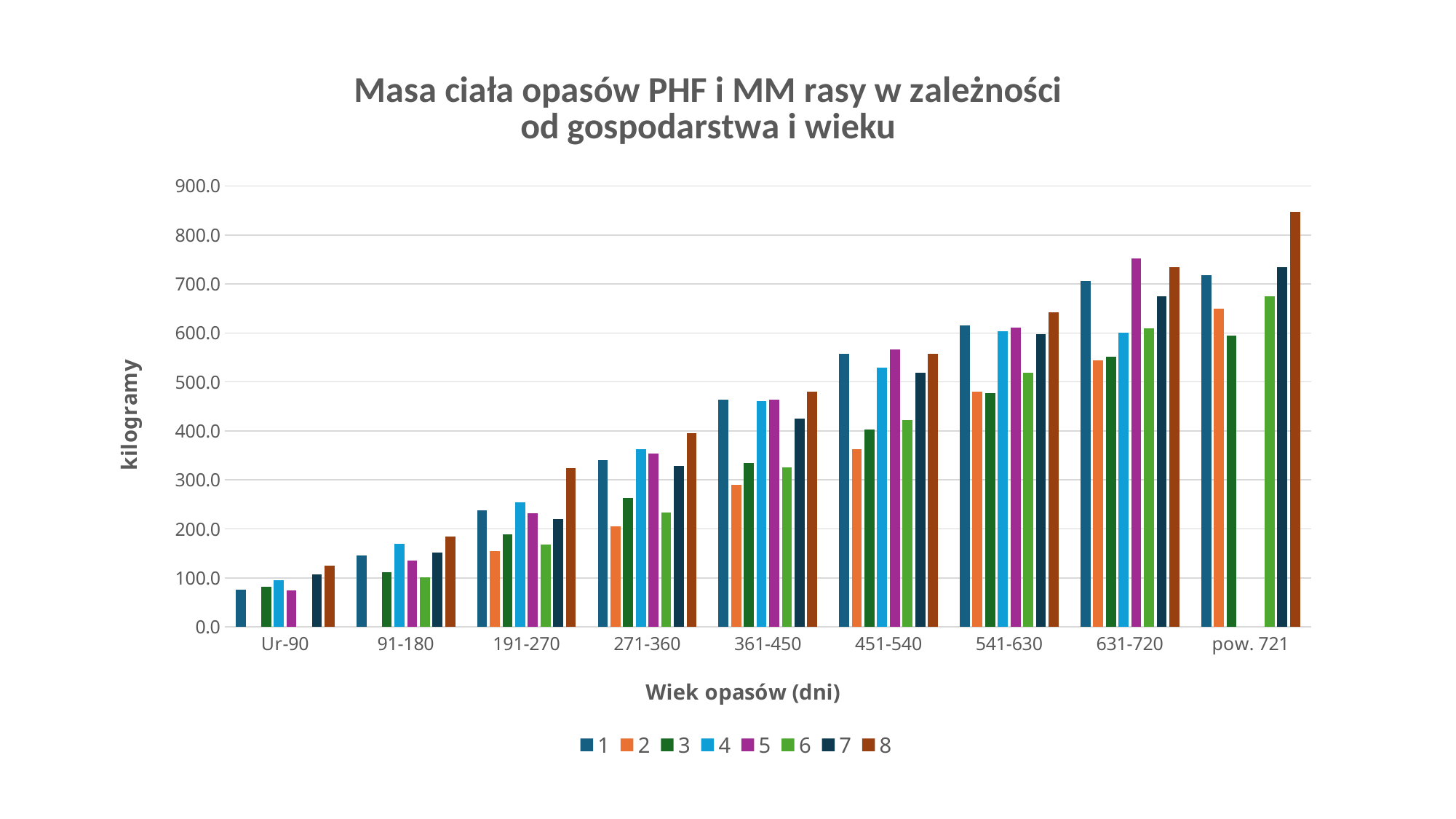
Is the value for series 8 in the 'pow. 721' category greater or less than 800? greater Which series has the highest bar in the whole chart? 8 In the '631-720' category, which is larger: series 1 or series 5? 5 What is the label of the y axis? kilogramy How many series does the legend list? 8 How many age categories are shown on the x axis? 9 Is the value for series 5 in the '631-720' category greater or less than 700? greater In the '451-540' category, which series has the lowest bar? 2 What kind of chart is shown on the slide? bar chart Is the value for series 1 in the 'Ur-90' category greater or less than 100? less Do the values for series 8 rise or fall as age increases along the x axis? rise